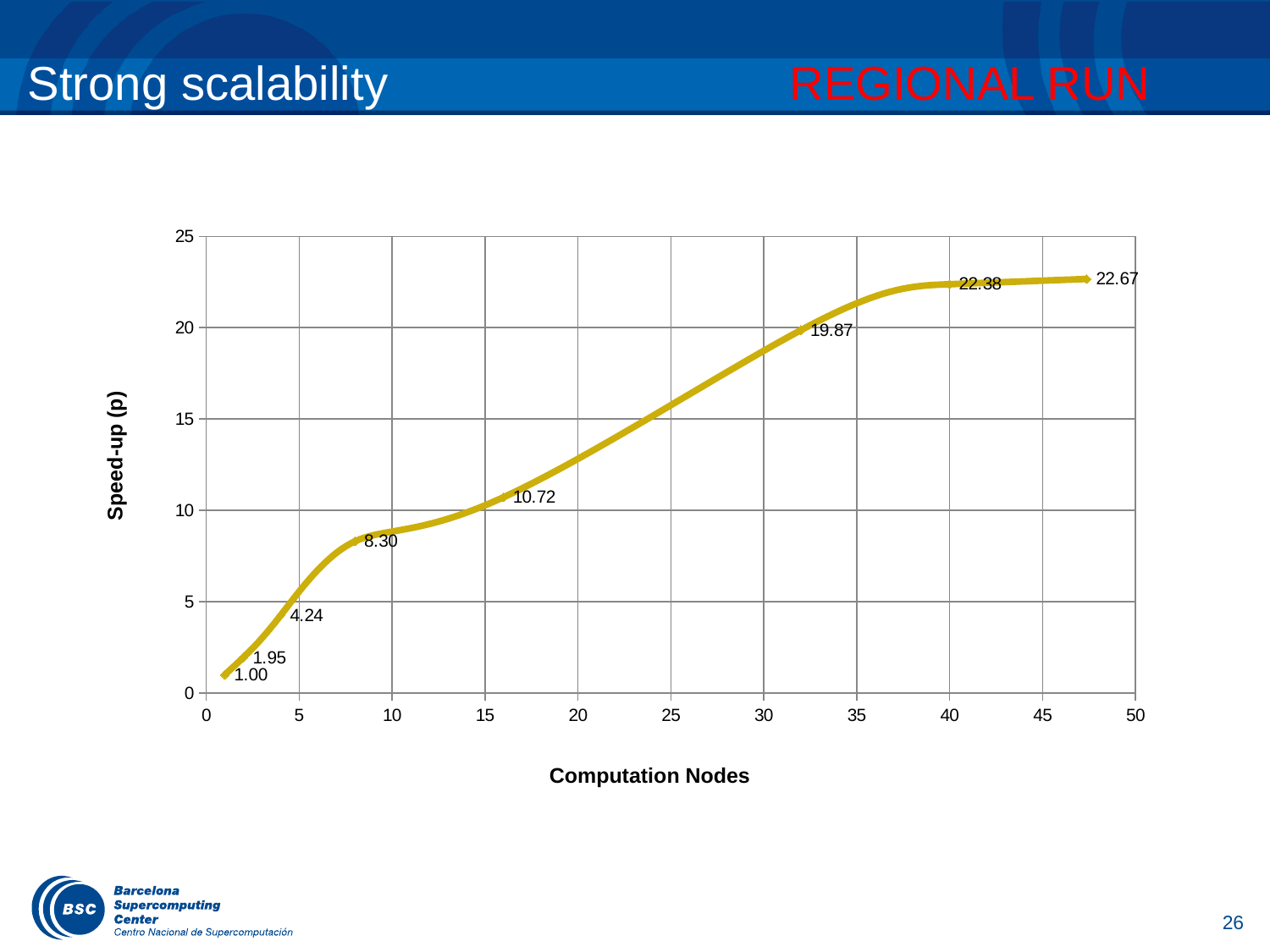
What kind of chart is shown on the slide? line chart What is the speed-up value labeled at the point near 32 computation nodes? 19.87 What is the lowest speed-up value labeled on the chart? 1.00 What is the speed-up value of the third labeled data point from the left? 4.24 What is the speed-up value of the last (rightmost) data point? 22.67 Is the speed-up at the point near 16 computation nodes greater or less than 10? greater What is the difference between the last two labeled speed-up values, 22.67 and 22.38? 0.29 Which is larger, the speed-up labeled 8.30 or the one labeled 10.72? 10.72 What is the title of the x axis? Computation Nodes What is the highest speed-up value labeled on the chart? 22.67 How many data points are labeled on the chart? 8 Does the speed-up rise or fall as the number of computation nodes increases? rises